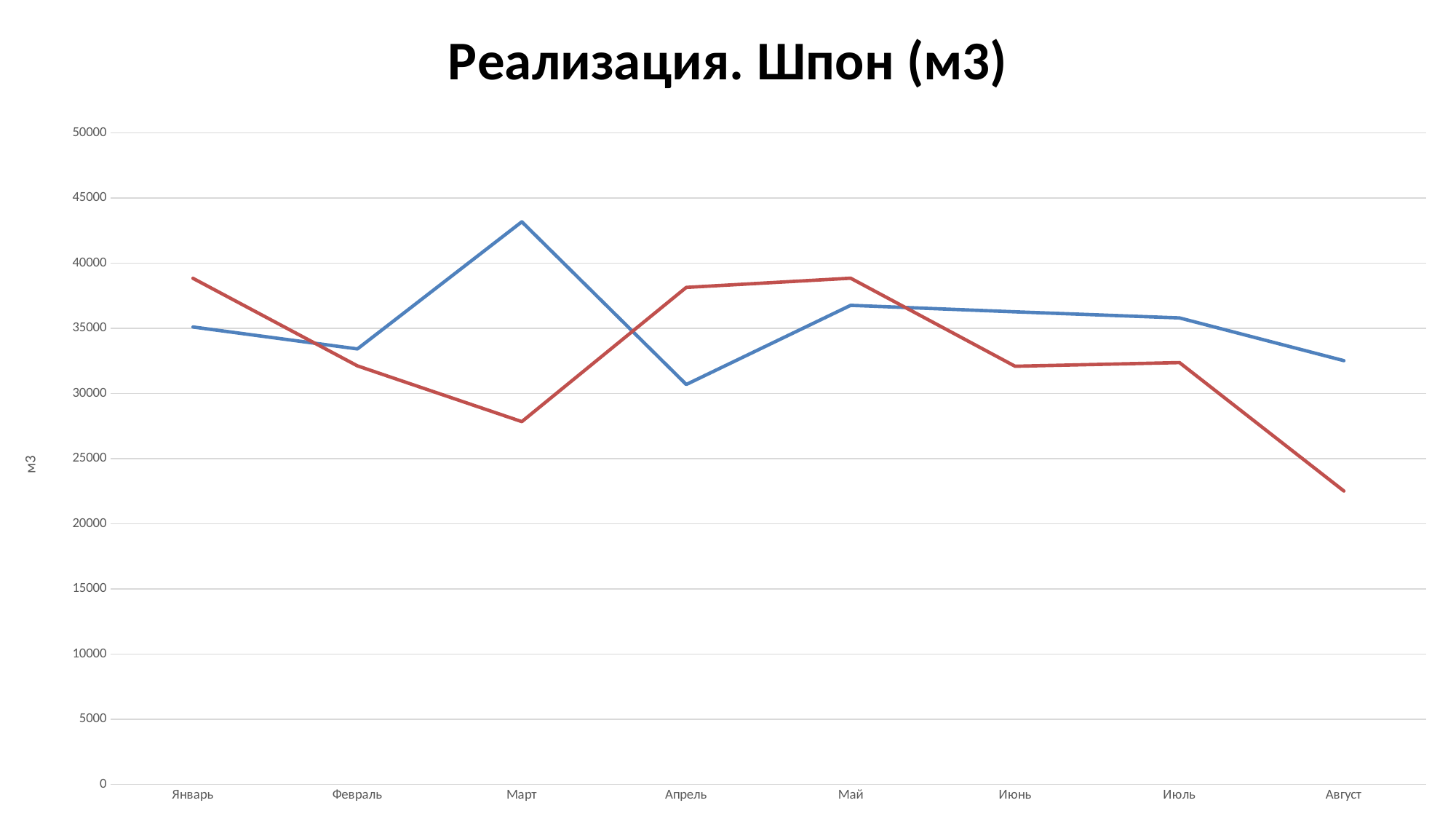
How many months are shown along the x axis? 8 In which month does the blue line reach its lowest value? Апрель Is the value of the red line in Август greater or less than 25000? less Does the red line rise or fall from Май to Август? fall Is the value of the blue line in Март greater or less than 40000? greater How many lines are plotted on the chart? 2 What is the title of the chart? Реализация. Шпон (м3) In which month does the blue line reach its highest value? Март Is the value of the red line in Март greater or less than 30000? less What kind of chart is shown on the slide? line chart In which month does the red line reach its lowest value? Август In Январь, which line has the higher value, the blue line or the red line? the red line